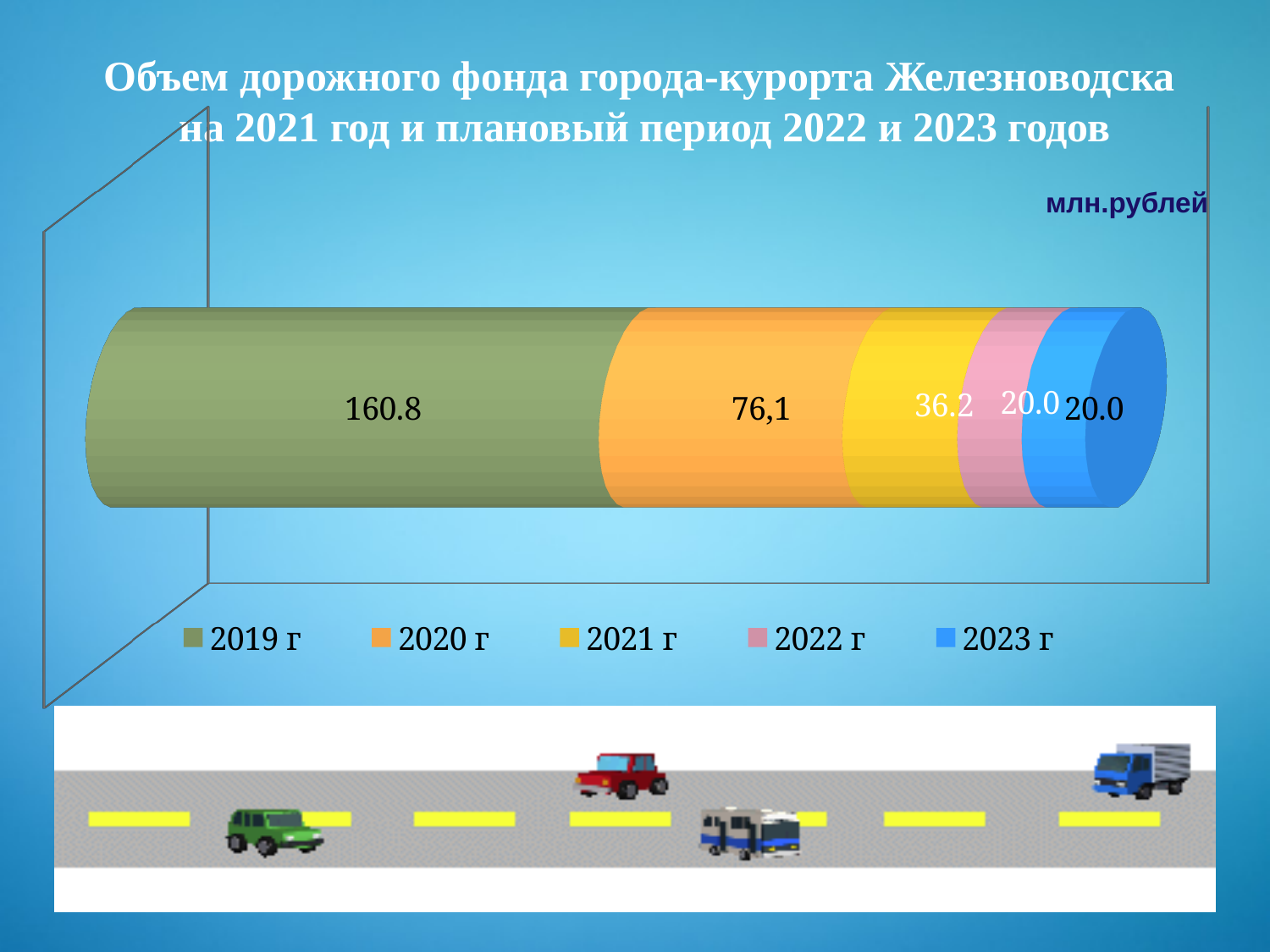
What is the difference between the values for 2019 г and 2020 г? 84.7 Which is larger, the value for 2020 г or the value for 2021 г? 2020 г What is the value for 2020 г? 76,1 What kind of chart is shown on the slide? Stacked bar chart What unit of measurement is indicated for the chart values? млн.рублей Which year has the highest value? 2019 г What is the difference between the values for 2021 г and 2022 г? 16.2 What is the value for 2019 г? 160.8 What is the value for 2021 г? 36.2 What is the total of all segments in the stacked bar? 313.1 How many series does the legend list? 5 What is the value for 2022 г? 20.0